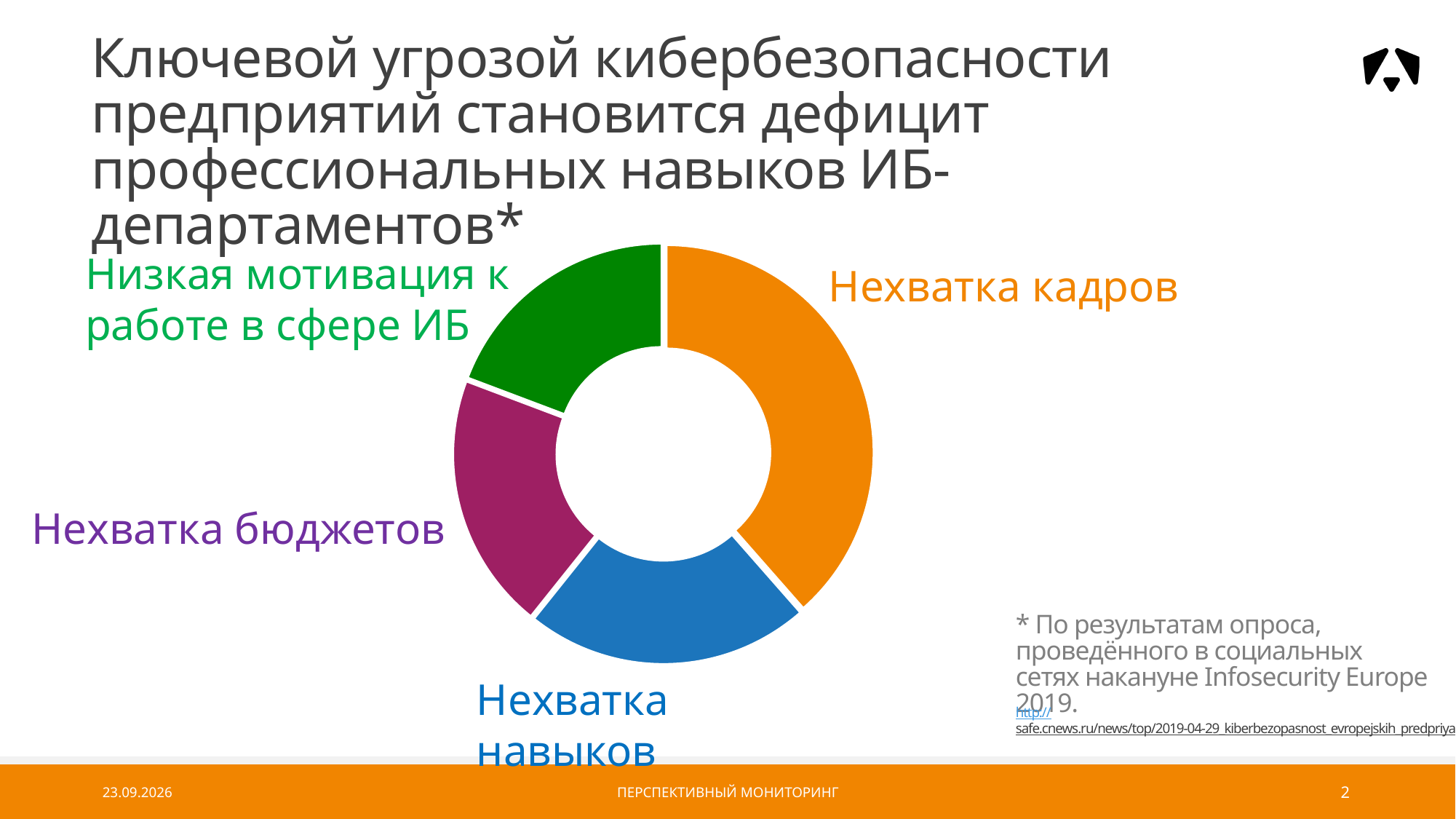
Which is larger: the share for Нехватка кадров or the share for Нехватка навыков? Нехватка кадров What kind of chart is shown on the slide? doughnut (pie) chart What colour is the segment for Нехватка кадров? orange How many segments does the chart have? 4 Which is larger: the share for Нехватка кадров or the share for Низкая мотивация к работе в сфере ИБ? Нехватка кадров Which category has the largest share of the chart? Нехватка кадров Which category is shown in blue? Нехватка навыков